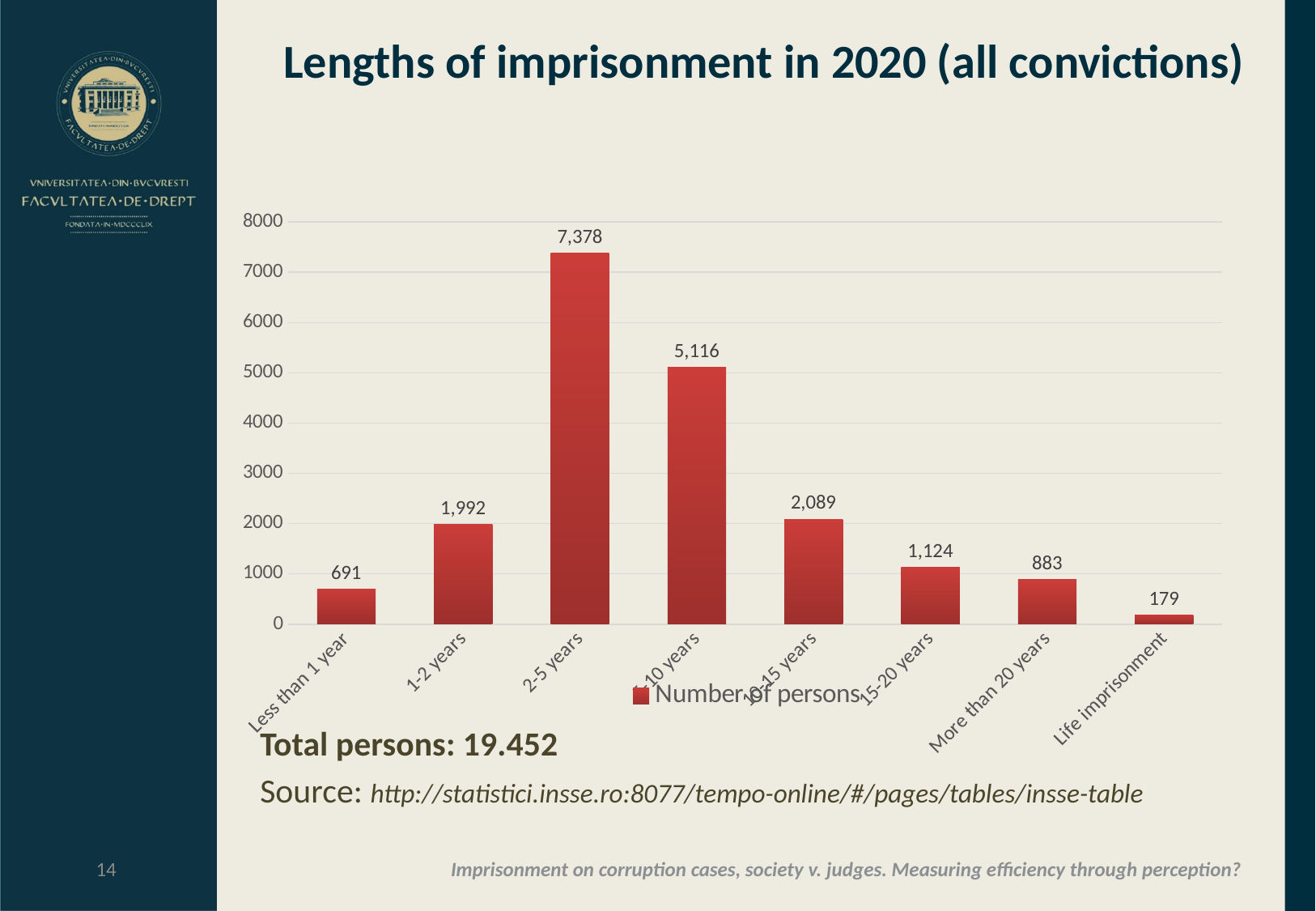
Which sentence length category has the highest number of persons? 2-5 years What type of chart is shown on the slide? bar chart What is the number of persons for 'Life imprisonment'? 179 What is the difference between the number of persons sentenced to 2-5 years and those sentenced to 1-2 years? 5,386 Which is larger: the value for 15-20 years or the value for More than 20 years? 15-20 years How many persons received a sentence of 1-2 years? 1,992 How many sentence length categories are shown on the x axis? 8 How many persons were sentenced to more than 20 years? 883 Which category has the lowest number of persons? Life imprisonment What series name does the legend show? Number of persons What is the value for the 'Less than 1 year' category? 691 How many persons were sentenced to 2-5 years of imprisonment? 7,378